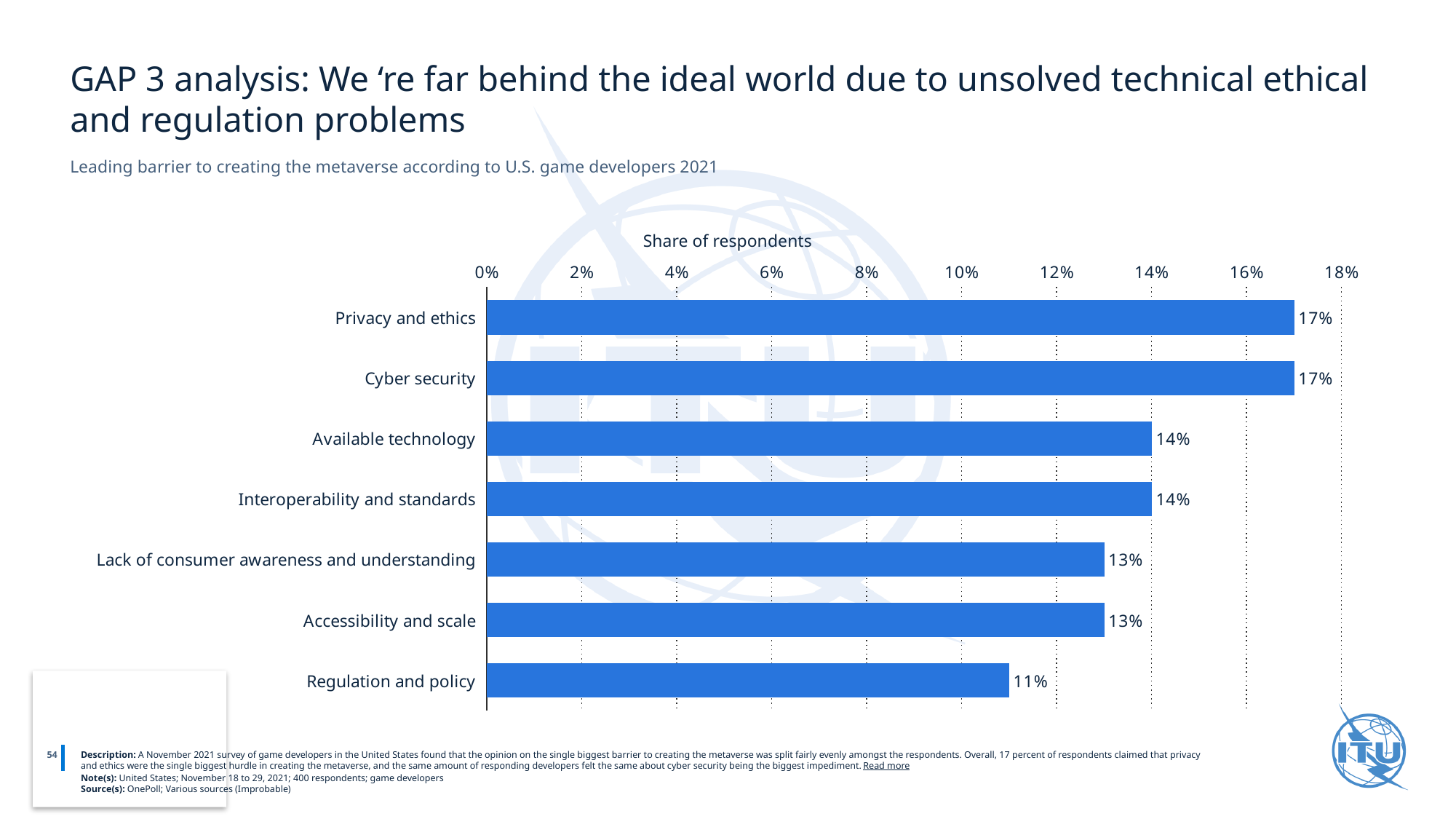
What is the value for Available technology? 14% What kind of chart is shown on the slide? bar chart Which is larger, the value for Available technology or the value for Accessibility and scale? Available technology What share of respondents is shown for Regulation and policy? 11% Is the value for Regulation and policy greater or less than 12%? less What is the difference between the values for Cyber security and Regulation and policy? 6% What is the value for Lack of consumer awareness and understanding? 13% What share of respondents named Privacy and ethics as the leading barrier? 17% What is the difference between the values for Interoperability and standards and Accessibility and scale? 1% How many categories are shown in the chart? 7 What is the label on the value axis of the chart? Share of respondents Which category has the lowest share of respondents? Regulation and policy